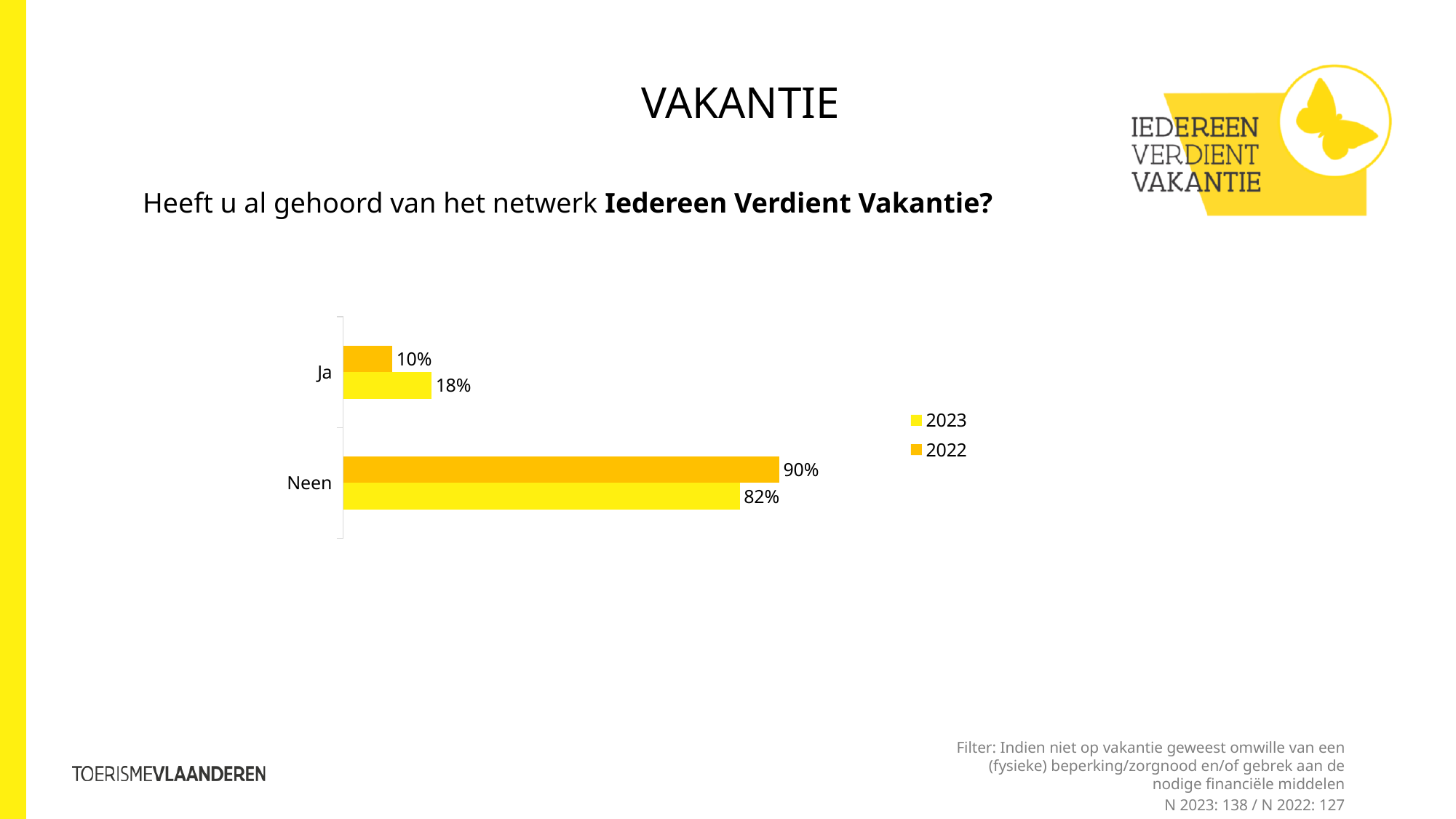
Which is larger for Ja: the 2023 value or the 2022 value? 2023 How many categories are shown on the chart? 2 What is the value for Ja in 2022? 10% What is the value for Ja in 2023? 18% Which category has the lowest value in the 2022 series? Ja Which category has the highest value in the 2023 series? Neen What is the difference between the Ja values for 2023 and 2022? 8% What kind of chart is shown on the slide? Bar chart What is the value for Neen in 2023? 82% What is the value for Neen in 2022? 90% What is the difference between the Neen values for 2022 and 2023? 8% How many series does the legend list? 2